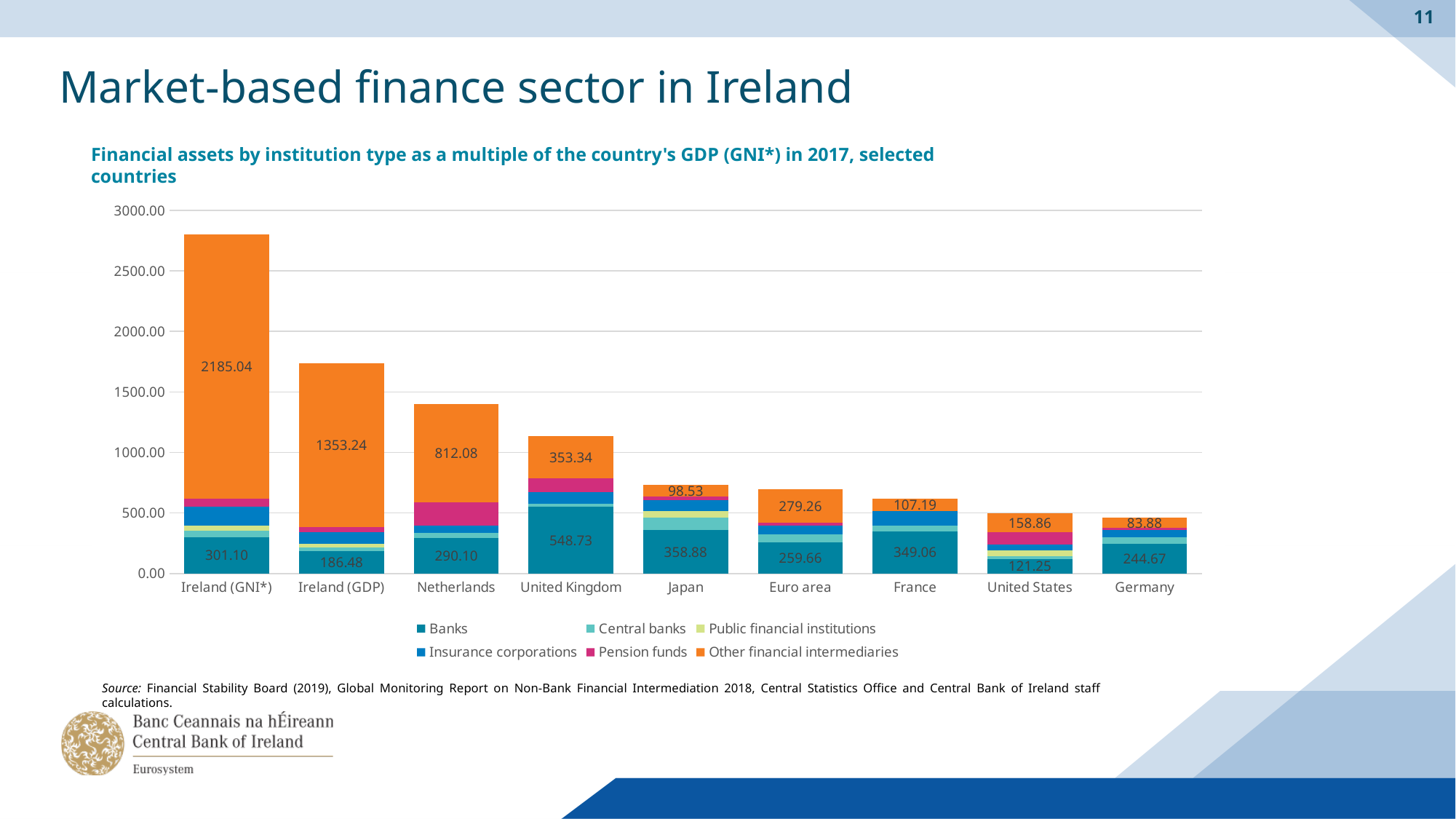
Which country has the lowest value for Banks? United States What is the value for Banks for the United Kingdom? 548.73 What is the difference between the Other financial intermediaries values for Ireland (GNI*) and Ireland (GDP)? 831.80 How many countries or regions are shown on the x axis? 9 How many series does the legend list? 6 Which country has the highest value for Other financial intermediaries? Ireland (GNI*) Which is larger, the Other financial intermediaries value for the Euro area or for the United States? Euro area What kind of chart is shown on the slide? Stacked bar chart Is the total stacked value for the Netherlands greater or less than 1000.00? greater What is the value for Banks for Ireland (GNI*)? 301.10 What is the value for Other financial intermediaries for Germany? 83.88 What is the value for Other financial intermediaries for the Netherlands? 812.08